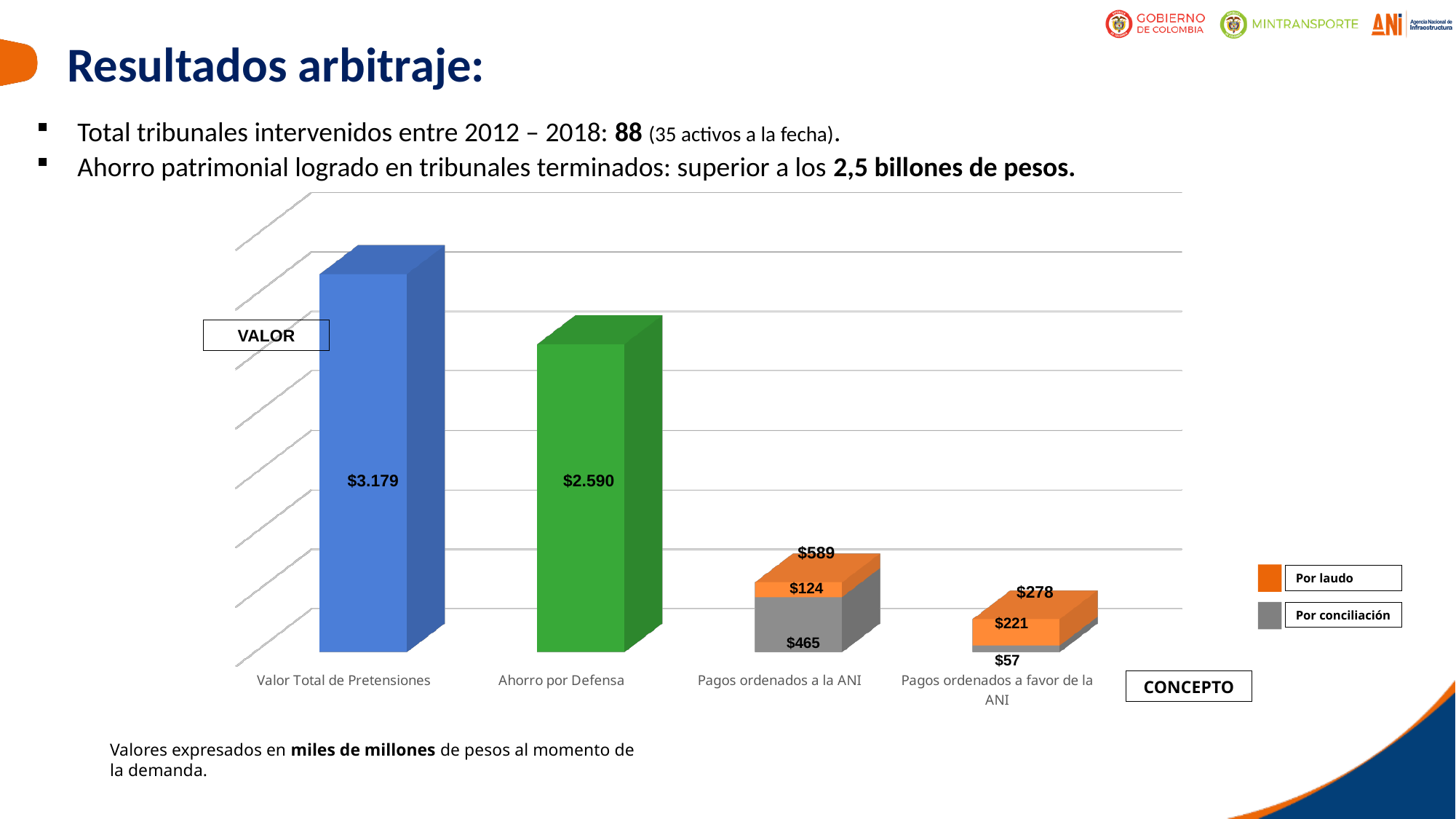
What is the value shown for Ahorro por Defensa? $2.590 What is the value shown for Valor Total de Pretensiones? $3.179 Which is larger for Pagos ordenados a la ANI: the Por laudo value or the Por conciliación value? Por conciliación What is the total shown for the Pagos ordenados a la ANI bar? $589 How many categories are shown on the x axis? 4 Which category has the lowest total value? Pagos ordenados a favor de la ANI How many entries does the legend list? 2 What is the difference between Valor Total de Pretensiones and Ahorro por Defensa? $589 What is the total shown for the Pagos ordenados a favor de la ANI bar? $278 What is the Por conciliación value for Pagos ordenados a favor de la ANI? $57 Which category has the highest value? Valor Total de Pretensiones What is the Por laudo value for Pagos ordenados a la ANI? $124